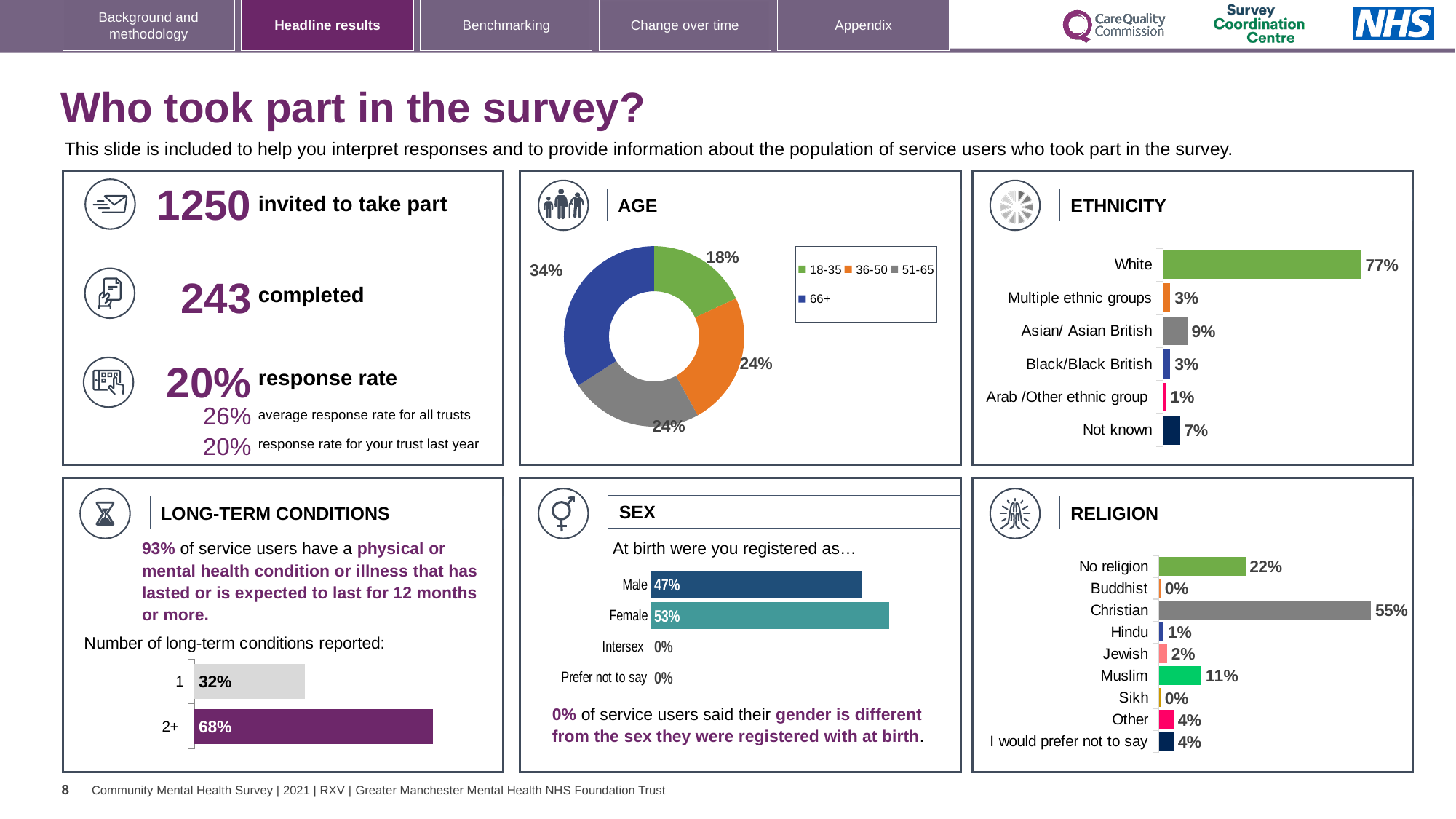
What type of chart is the AGE chart? Donut chart In the AGE chart, what percentage of respondents were aged 66+? 34% In the RELIGION chart, what is the value for Muslim? 11% In the SEX chart, what is the difference between the Female and Male values? 6% In the ETHNICITY chart, what is the value for Asian/ Asian British? 9% In the SEX chart, which is larger, Male or Female? Female In the RELIGION chart, which category has the highest value? Christian In the LONG-TERM CONDITIONS chart, what percentage reported 2+ conditions? 68% How many age groups does the legend of the AGE chart list? 4 In the ETHNICITY chart, what is the difference between the values for White and Not known? 70% In the ETHNICITY chart, which category has the highest value? White How many categories are shown in the ETHNICITY chart? 6